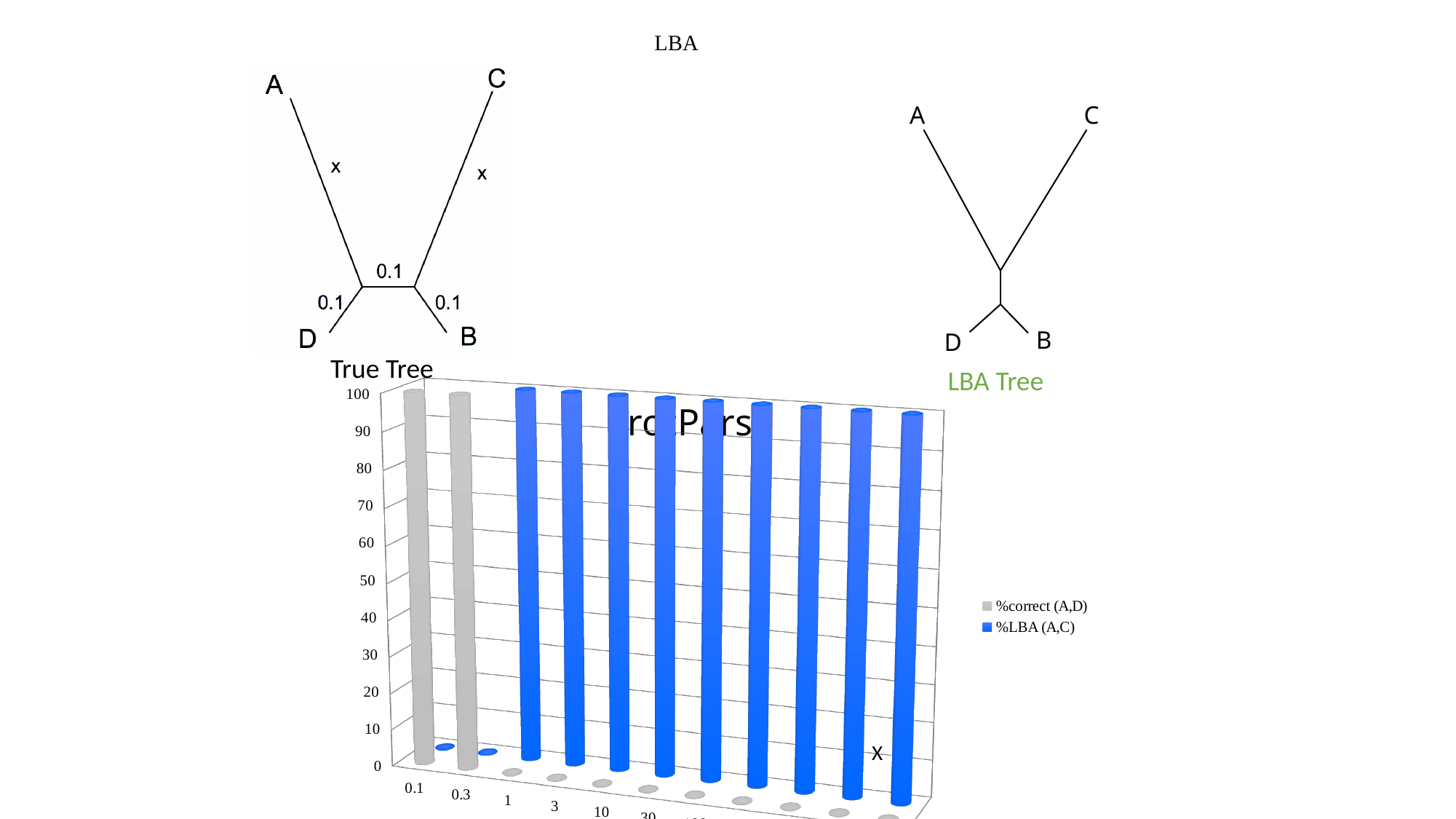
What are the two series named in the chart legend? %correct (A,D) and %LBA (A,C) At category 10, which series has the larger value, %correct (A,D) or %LBA (A,C)? %LBA (A,C) Does the %LBA (A,C) series rise or fall going from category 0.3 to category 1? rise What kind of chart is shown on the slide? bar chart How many series does the chart legend list? 2 At category 0.3, which series has the larger value, %correct (A,D) or %LBA (A,C)? %correct (A,D) Is the value of %LBA (A,C) at category 0.1 greater or less than 10? less Is the value of %correct (A,D) at category 3 greater or less than 10? less For how many categories is the %correct (A,D) bar above 50? 2 Is the value of %correct (A,D) at category 0.1 greater or less than 90? greater Which colour represents the %LBA (A,C) series in the chart? blue